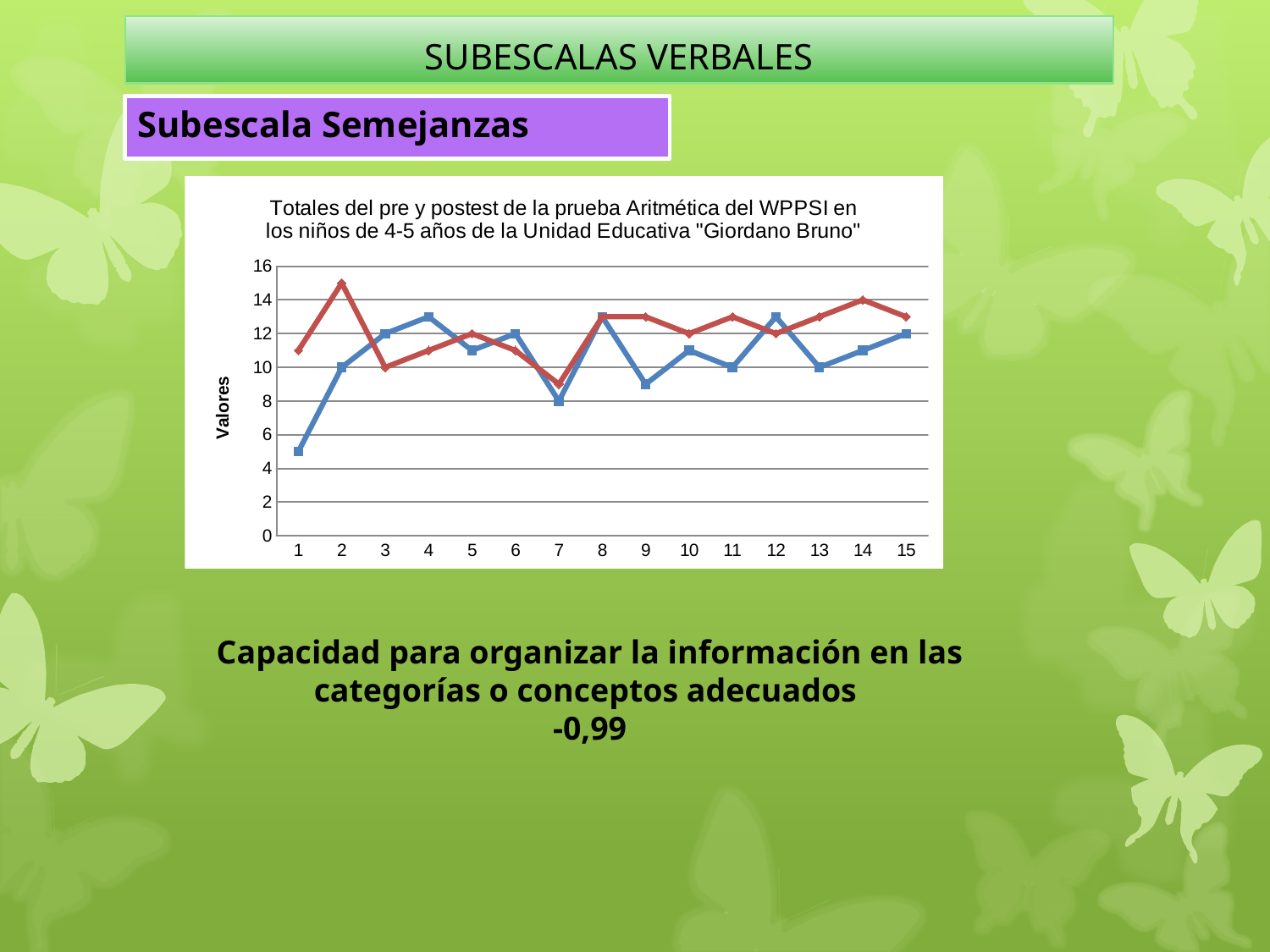
Is the value of the blue line at point 1 greater or less than 6? less At point 1, which line has the larger value, the red line or the blue line? red line What kind of chart is shown on the slide? line chart How many points are plotted along the x axis of the chart? 15 What is the value of the blue line at point 7? 8 At which x-axis point does the blue line reach its lowest value? 1 At which x-axis point does the red line reach its highest value? 2 What is the value of the blue line at point 2? 10 How many lines (data series) are plotted on the chart? 2 What is the value of the red line at point 3? 10 What is the value of the red line at point 14? 14 Is the value of the red line at point 2 greater or less than 14? greater